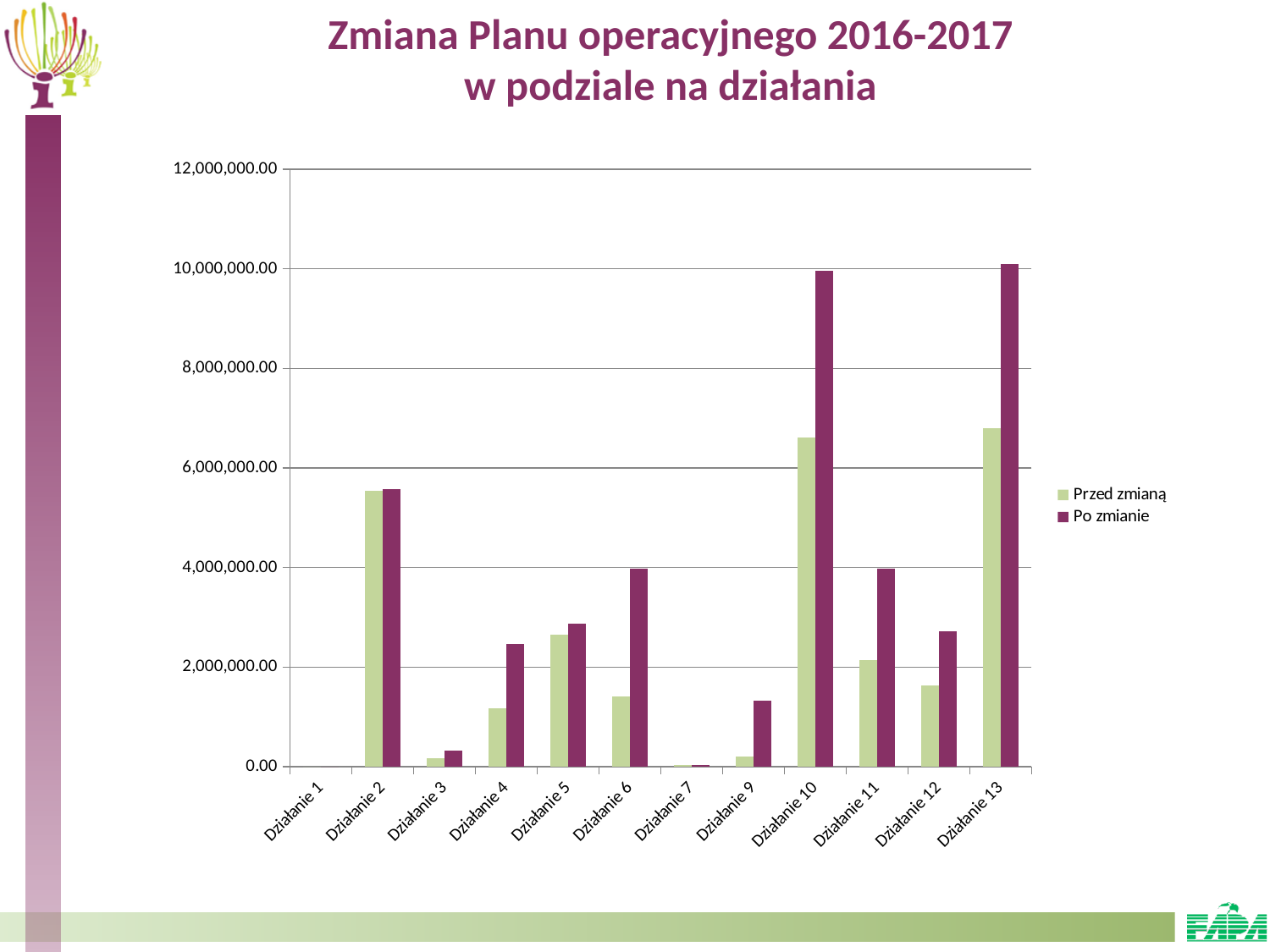
How many series does the legend list? 2 Is the Przed zmianą value for Działanie 4 greater or less than 2,000,000.00? less What kind of chart is shown on the slide? bar chart What is the title of the chart? Zmiana Planu operacyjnego 2016-2017 w podziale na działania Is the Przed zmianą value for Działanie 2 greater or less than 4,000,000.00? greater Is the Po zmianie value for Działanie 10 greater or less than 8,000,000.00? greater What are the two series named in the legend? Przed zmianą and Po zmianie How many categories (działania) are shown on the x axis? 12 For Działanie 6, which is larger: Przed zmianą or Po zmianie? Po zmianie For Działanie 11, which is larger: Przed zmianą or Po zmianie? Po zmianie